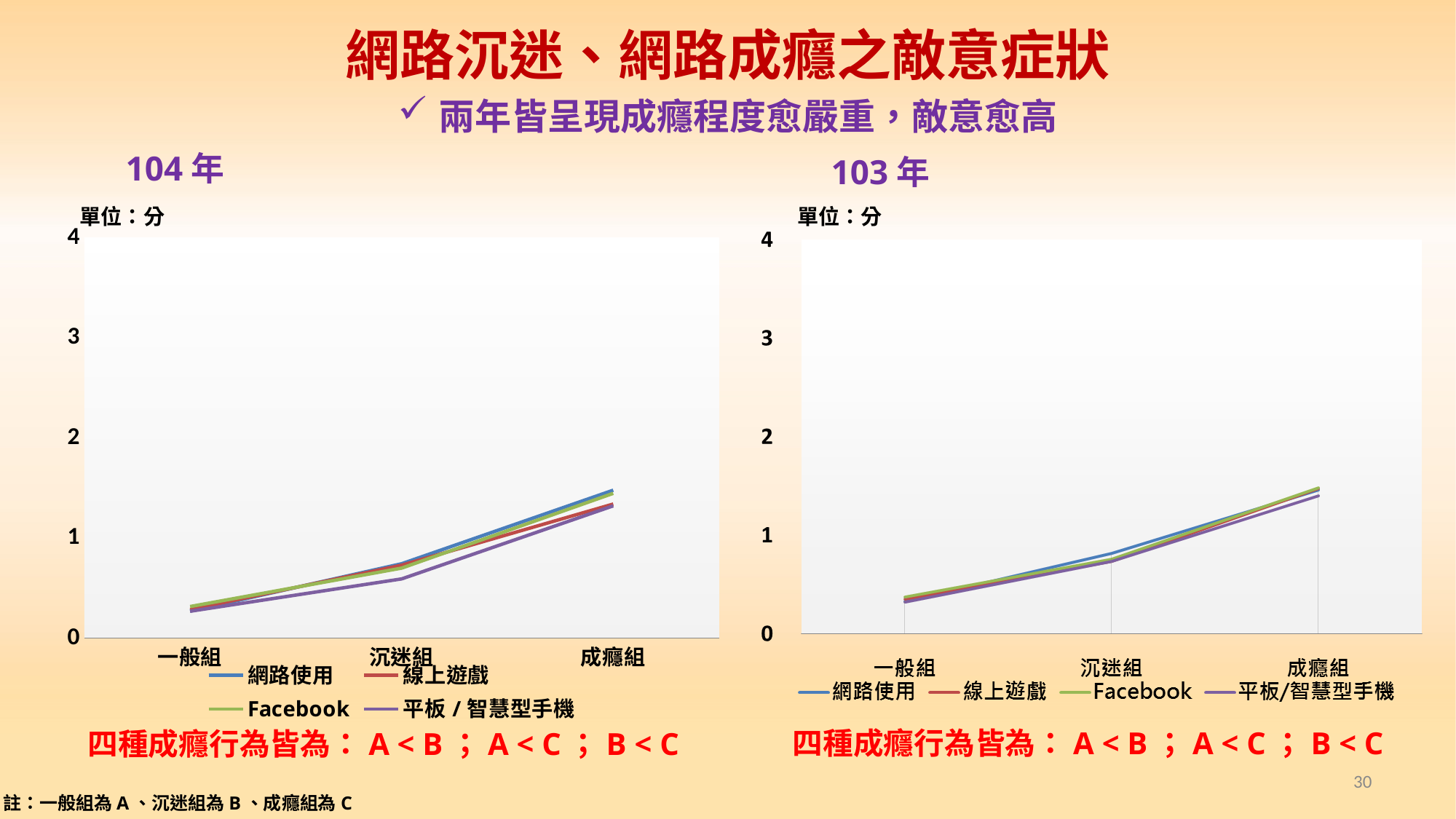
In the 104 年 chart, which category has the highest value for 網路使用? 成癮組 How many series does the legend of the 104 年 chart list? 4 In the 103 年 chart, do the values rise or fall from 一般組 to 成癮組? rise In the 103 年 chart, is the value of 線上遊戲 for 成癮組 greater or less than 1? greater What kind of chart is the 104 年 chart on the left? line chart In the 103 年 chart, which category has the lowest value for 平板/智慧型手機? 一般組 In the 103 年 chart, is the value of Facebook for 沉迷組 greater or less than 1? less In the 104 年 chart, is the value of 平板 / 智慧型手機 for 一般組 greater or less than 1? less In the 104 年 chart, do the values rise or fall from 一般組 to 成癮組? rise What unit is stated above the 104 年 chart? 分 How many categories are shown on the x axis of the 103 年 chart on the right? 3